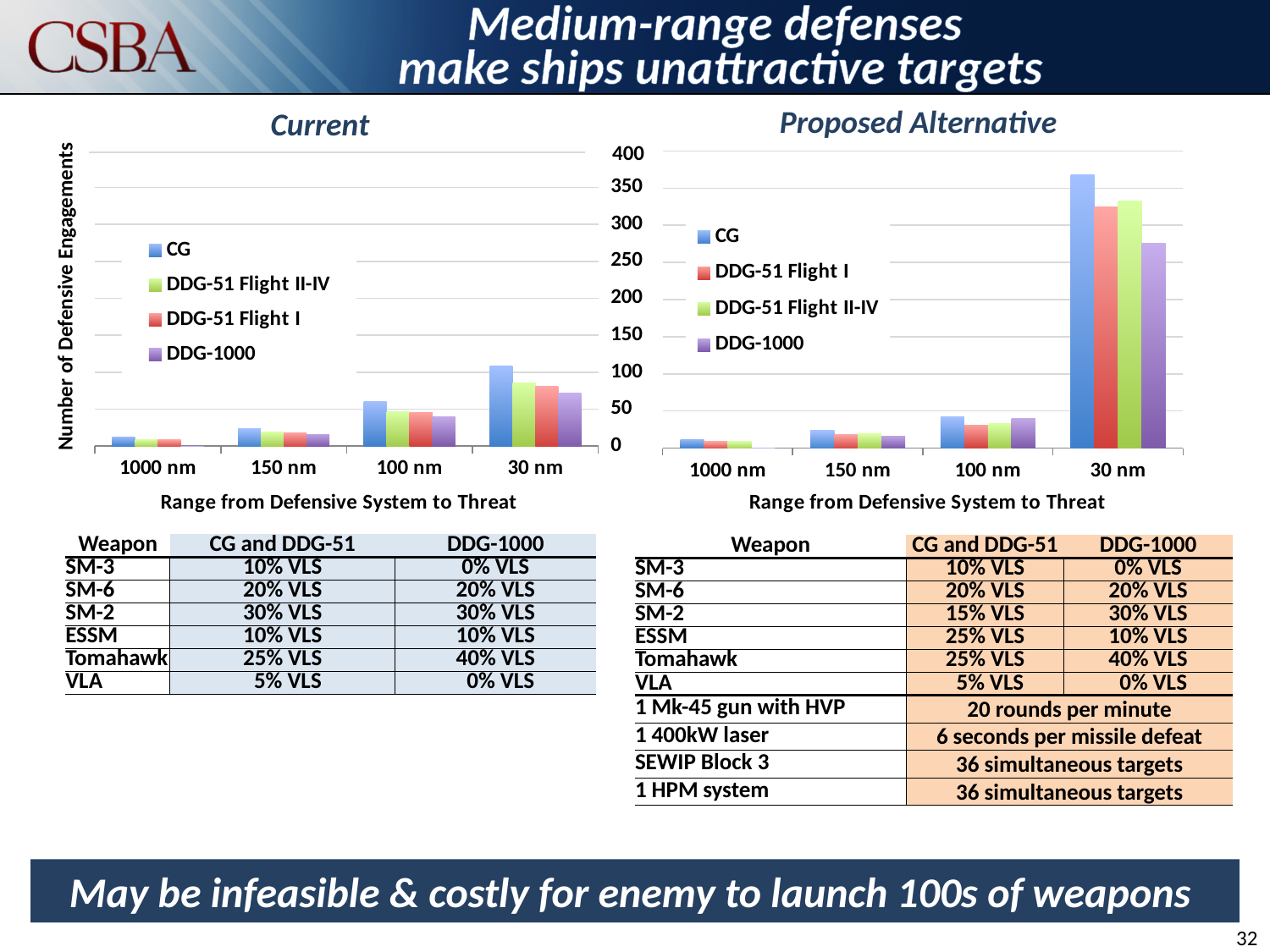
In the "Current" chart, which range category has the lowest number of defensive engagements? 1000 nm In the "Current" chart, which is larger at 30 nm: CG or DDG-1000? CG How many series does the legend of the "Current" chart list? 4 In the "Proposed Alternative" chart, do the number of defensive engagements rise or fall moving from 1000 nm to 30 nm along the x axis? rise In the "Proposed Alternative" chart, is the CG value at 30 nm greater or less than 350? greater What is the x-axis title of the "Current" chart? Range from Defensive System to Threat What kind of chart is the "Current" chart on the left? bar chart In the "Proposed Alternative" chart, is the DDG-1000 value at 30 nm greater or less than 300? less In the "Proposed Alternative" chart, which range category has the highest number of defensive engagements? 30 nm How many range categories are shown on the x axis of the "Proposed Alternative" chart? 4 In the "Proposed Alternative" chart, which is larger at 30 nm: CG or DDG-1000? CG In the "Proposed Alternative" chart, is the CG value at 100 nm greater or less than 50? less